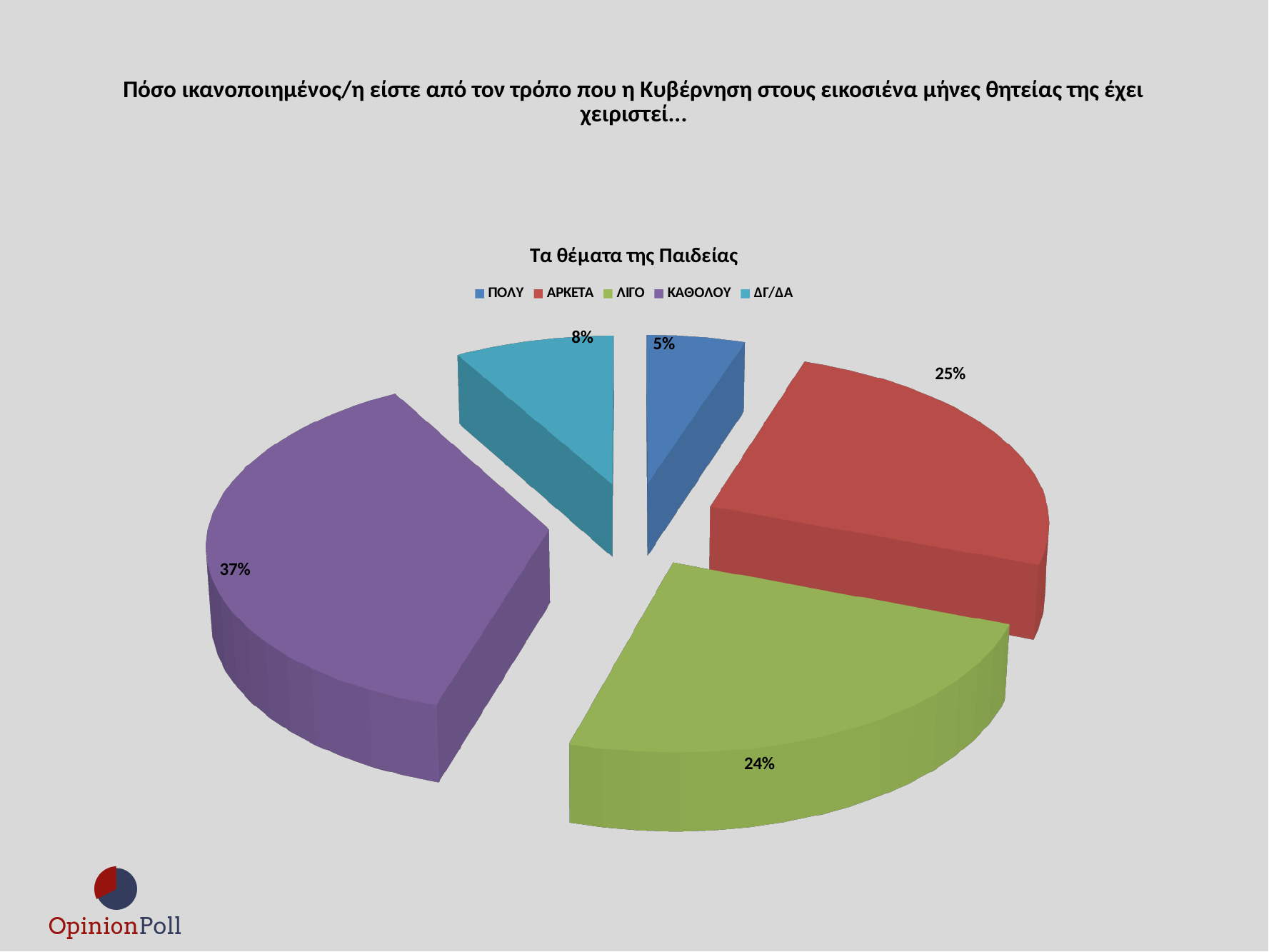
What is the difference in percentage points between ΚΑΘΟΛΟΥ and ΛΙΓΟ? 13 Which is larger, the share for ΑΡΚΕΤΑ or the share for ΛΙΓΟ? ΑΡΚΕΤΑ What percentage of the pie is ΑΡΚΕΤΑ? 25% Which category has the largest share of the pie? ΚΑΘΟΛΟΥ What colour is the ΛΙΓΟ slice? green What percentage of the pie is ΔΓ/ΔΑ? 8% What is the title of the chart? Τα θέματα της Παιδείας What percentage of the pie is ΚΑΘΟΛΟΥ? 37% What percentage of the pie is ΠΟΛΥ? 5% What type of chart is shown on the slide? pie chart Which category has the smallest share of the pie? ΠΟΛΥ How many categories does the legend list? 5